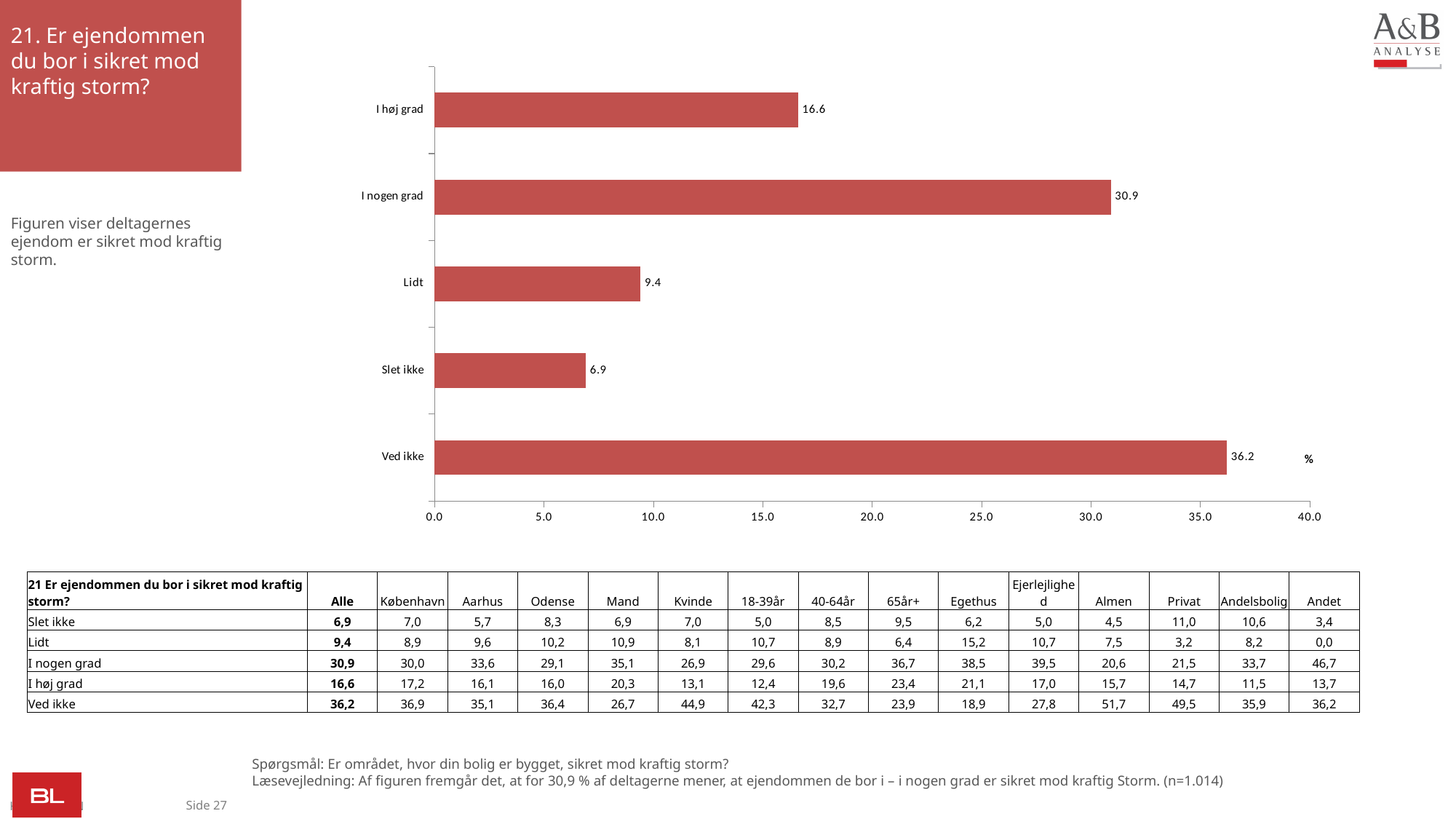
What kind of chart is shown on the slide? Bar chart Which category has the lowest value in the bar chart? Slet ikke What is the difference between the values for "I høj grad" and "Lidt" in the bar chart? 7.2 Which is larger in the bar chart: the value for "I høj grad" or the value for "Lidt"? I høj grad What is the value for "Ved ikke" in the bar chart? 36.2 How many categories are shown in the bar chart? 5 Is the value for "I nogen grad" greater or less than 25.0? greater Which category has the highest value in the bar chart? Ved ikke What is the value for "Slet ikke" in the bar chart? 6.9 What is the difference between the values for "Ved ikke" and "I nogen grad" in the bar chart? 5.3 What is the value for "I nogen grad" in the bar chart? 30.9 What is the maximum value shown on the x axis of the bar chart? 40.0